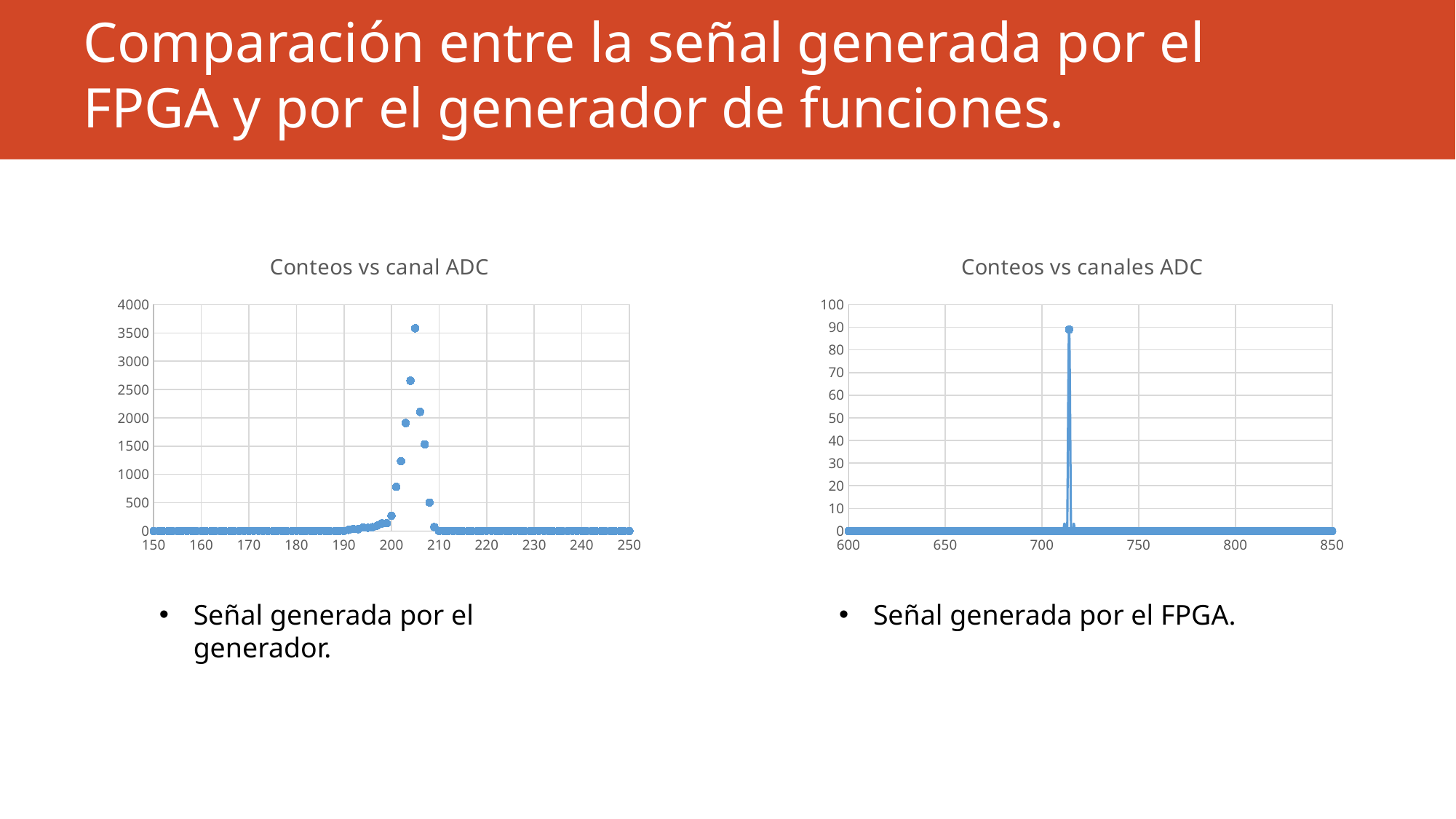
In the right chart 'Conteos vs canales ADC', is the x value at which the peak occurs greater or less than 750? less In the right chart 'Conteos vs canales ADC', is the highest plotted value greater or less than 80? greater What is the title of the right chart? Conteos vs canales ADC How many charts are shown on the slide? 2 In the left chart 'Conteos vs canal ADC', is the value at x = 160 greater or less than 500? less What is the maximum value shown on the x axis of the right chart 'Conteos vs canales ADC'? 850 What is the maximum value shown on the y axis of the left chart 'Conteos vs canal ADC'? 4000 What kind of chart is the left chart titled 'Conteos vs canal ADC'? scatter chart